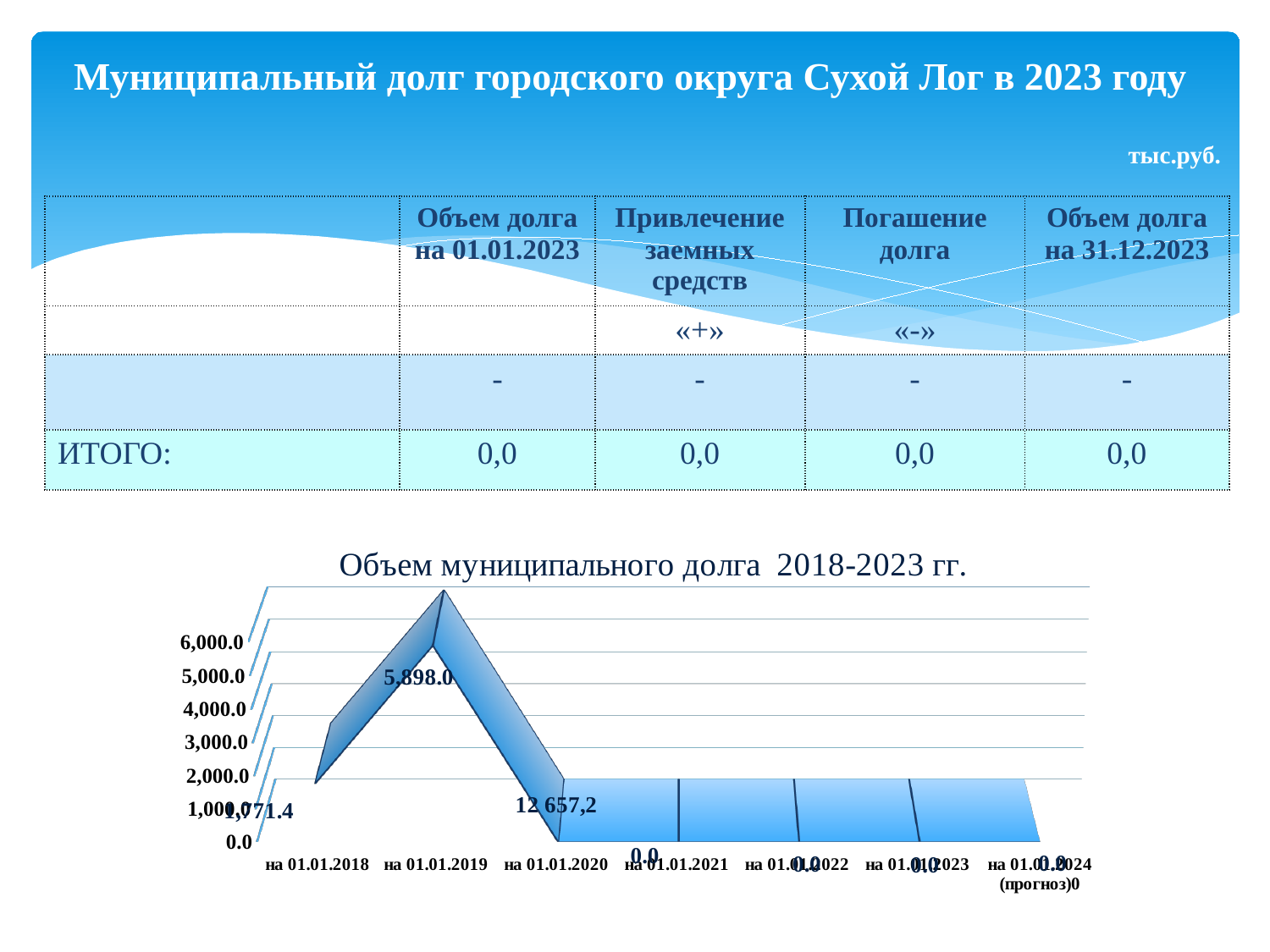
Is the value for на 01.01.2018 greater or less than 2,000.0? less What is the title of the chart on the slide? Объем муниципального долга 2018-2023 гг. Which date has the highest municipal debt value in the chart? на 01.01.2019 Does the municipal debt rise or fall from на 01.01.2019 to на 01.01.2020? fall Is the value for на 01.01.2019 greater or less than 5,000.0? greater In what units are the values on the slide expressed? тыс.руб. What is the value of municipal debt на 01.01.2019? 5,898.0 What is the value of municipal debt на 01.01.2021? 0.0 Which is larger: the debt на 01.01.2018 or на 01.01.2019? на 01.01.2019 How many dates (categories) are shown on the x axis of the chart? 7 What is the difference between the debt на 01.01.2019 and на 01.01.2021? 5,898.0 What is the value of municipal debt на 01.01.2023? 0.0